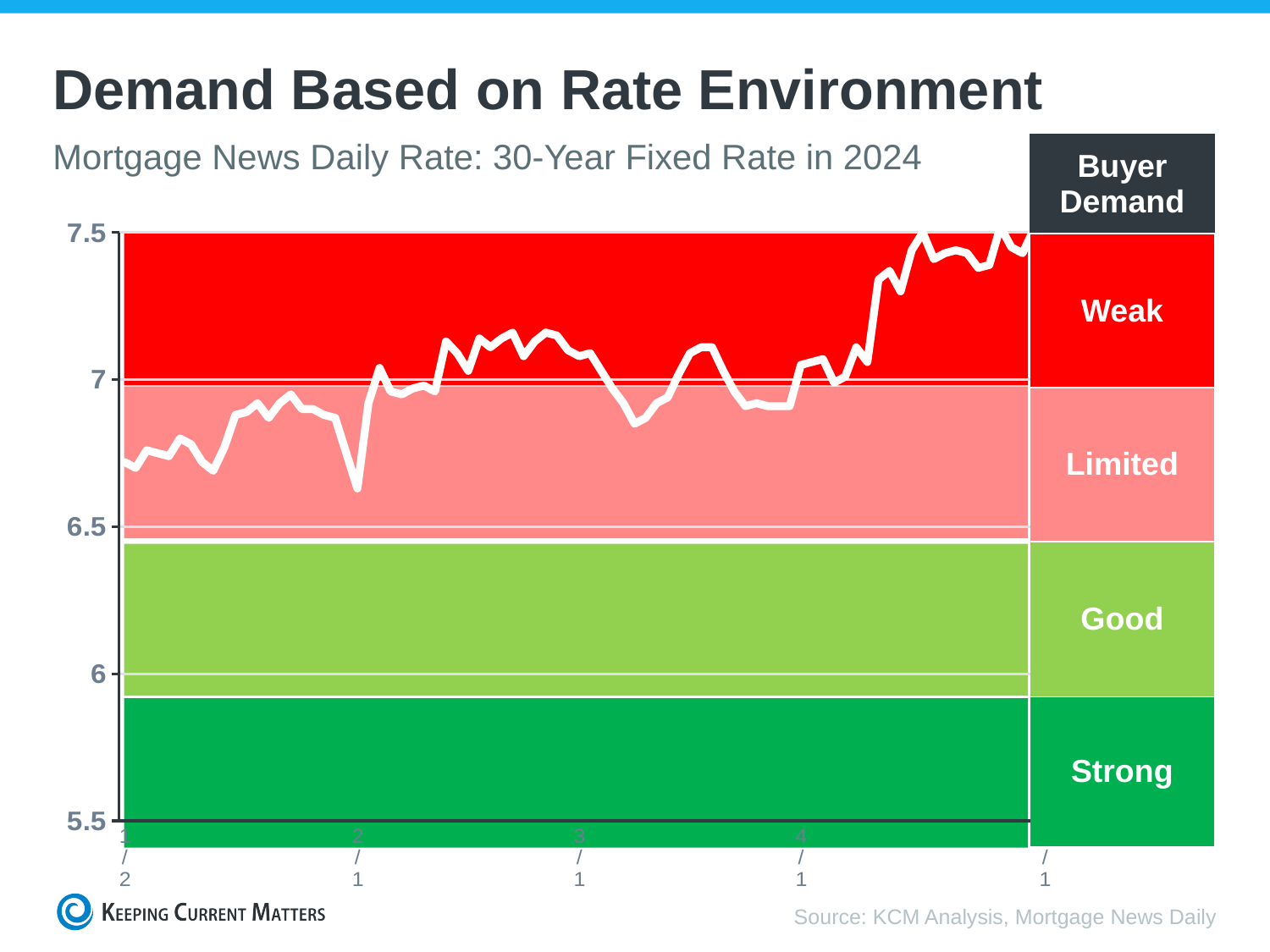
Is the rate around 3/1 greater or less than 7? greater Overall, does the 30-year fixed rate rise or fall from the start of 2024 to the end of the plotted period? rise What kind of chart is shown on the slide? line chart Is the highest rate plotted during the period greater or less than 7? greater Is the lowest rate plotted during the period greater or less than 6.5? greater Which buyer demand band is the rate in at the end of the plotted period? Weak How many buyer demand bands are shown on the chart? 4 Which buyer demand band corresponds to rates above 7? Weak